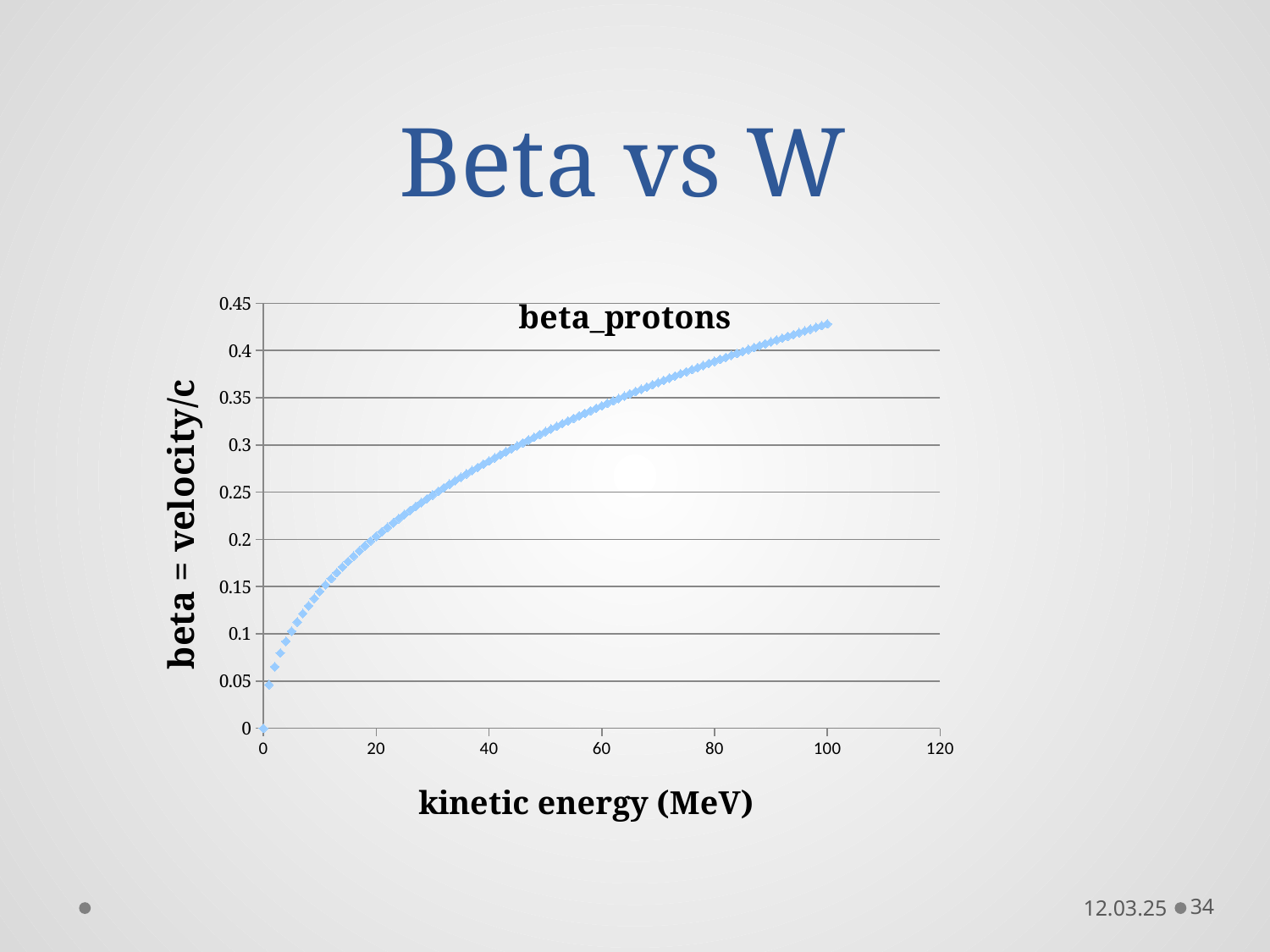
What is the label of the x axis? kinetic energy (MeV) Which has the larger beta value: the point at 20 MeV or the point at 80 MeV? 80 MeV Is the beta value at 40 MeV greater or less than 0.25? greater What is the highest kinetic energy value at which a point is plotted? 100 Is the beta value at 10 MeV greater or less than 0.2? less Is the beta value at 80 MeV greater or less than 0.35? greater What kind of chart is shown on the slide? scatter chart What is the title of the chart? beta_protons Do the beta values rise or fall as kinetic energy increases? rise